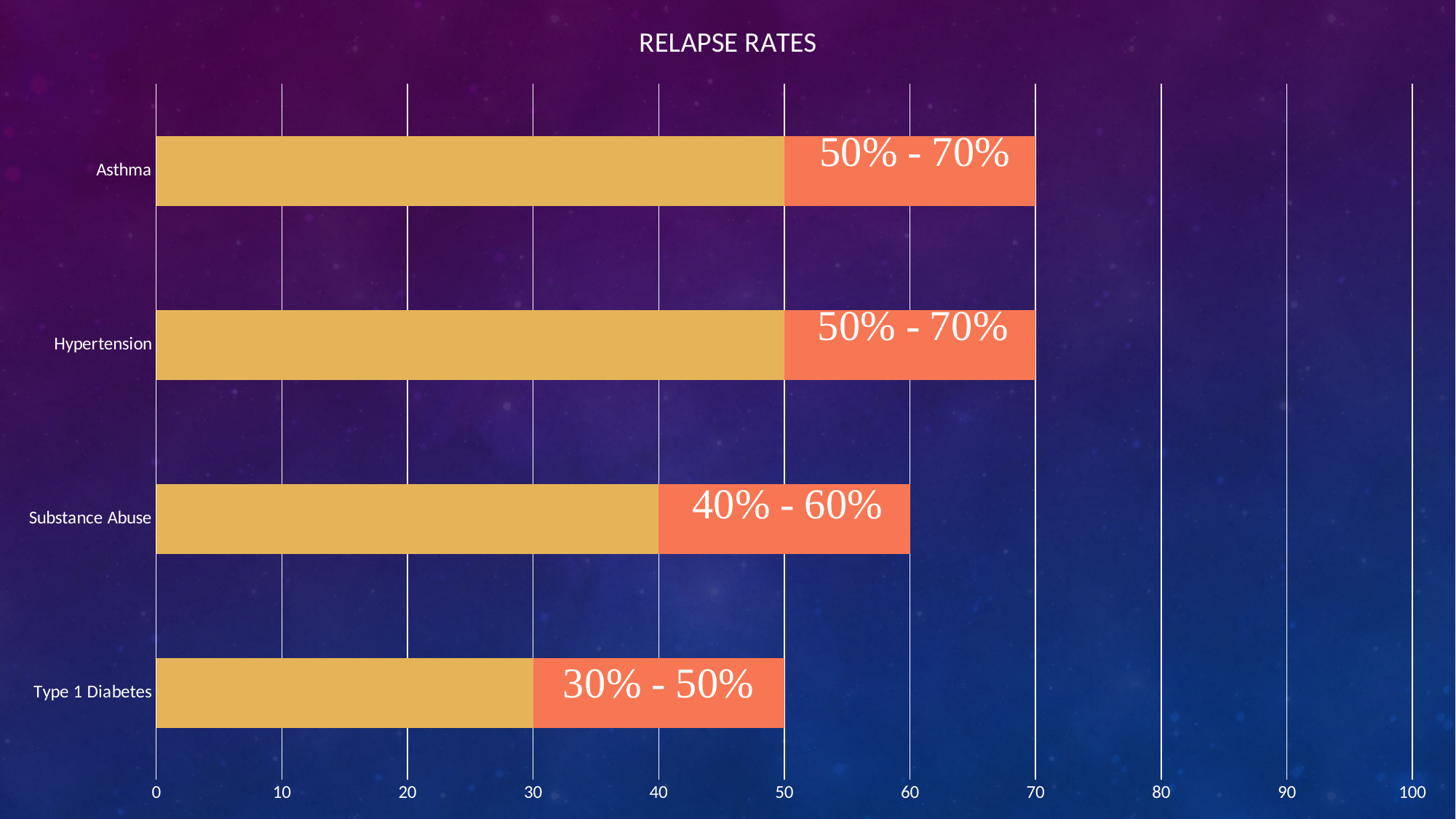
Is the upper end of the Substance Abuse bar greater or less than 50? greater What relapse rate range is shown for Substance Abuse? 40% - 60% What is the title of the chart? RELAPSE RATES What relapse rate range is shown for Type 1 Diabetes? 30% - 50% What kind of chart is shown on the slide? Bar chart Is the upper end of the Type 1 Diabetes bar greater or less than 60? less How many categories are shown in the chart? 4 Which category has the lowest relapse rate range? Type 1 Diabetes What relapse rate range is shown for Hypertension? 50% - 70% What relapse rate range is shown for Asthma? 50% - 70% Which has a higher relapse rate range, Substance Abuse or Type 1 Diabetes? Substance Abuse What is the difference between the upper and lower bounds of the Substance Abuse range? 20%